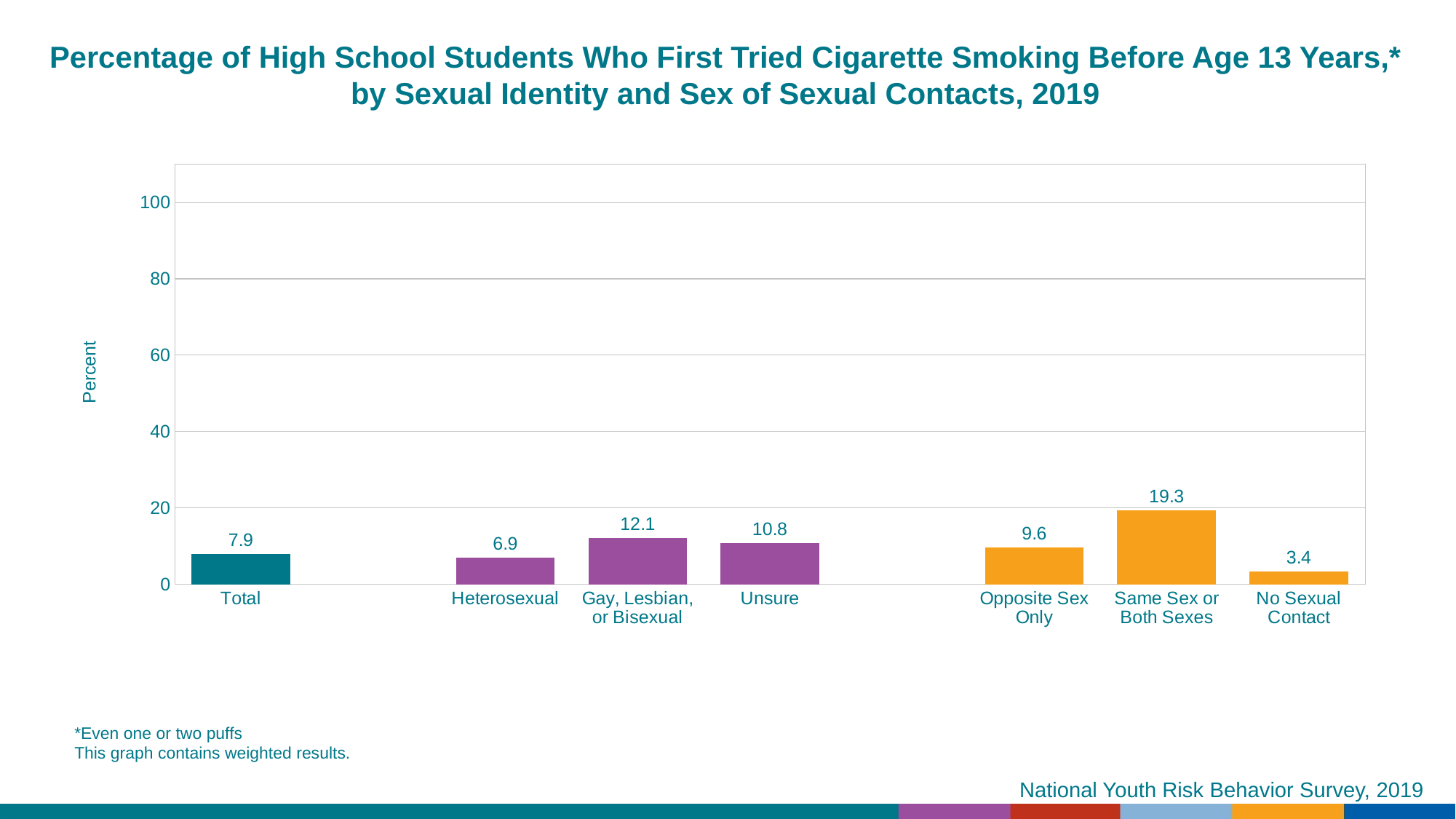
Is the value for Same Sex or Both Sexes greater or less than 20? less What is the difference between the values for Gay, Lesbian, or Bisexual and Heterosexual? 5.2 How many categories are shown on the chart? 7 What kind of chart is shown on the slide? Bar chart What is the value for No Sexual Contact? 3.4 What is the value for Total? 7.9 What is the label of the y axis? Percent Which is larger, the value for Unsure or the value for Opposite Sex Only? Unsure Which category has the lowest value? No Sexual Contact What is the value for Same Sex or Both Sexes? 19.3 What is the value for Heterosexual students? 6.9 Which category has the highest value? Same Sex or Both Sexes